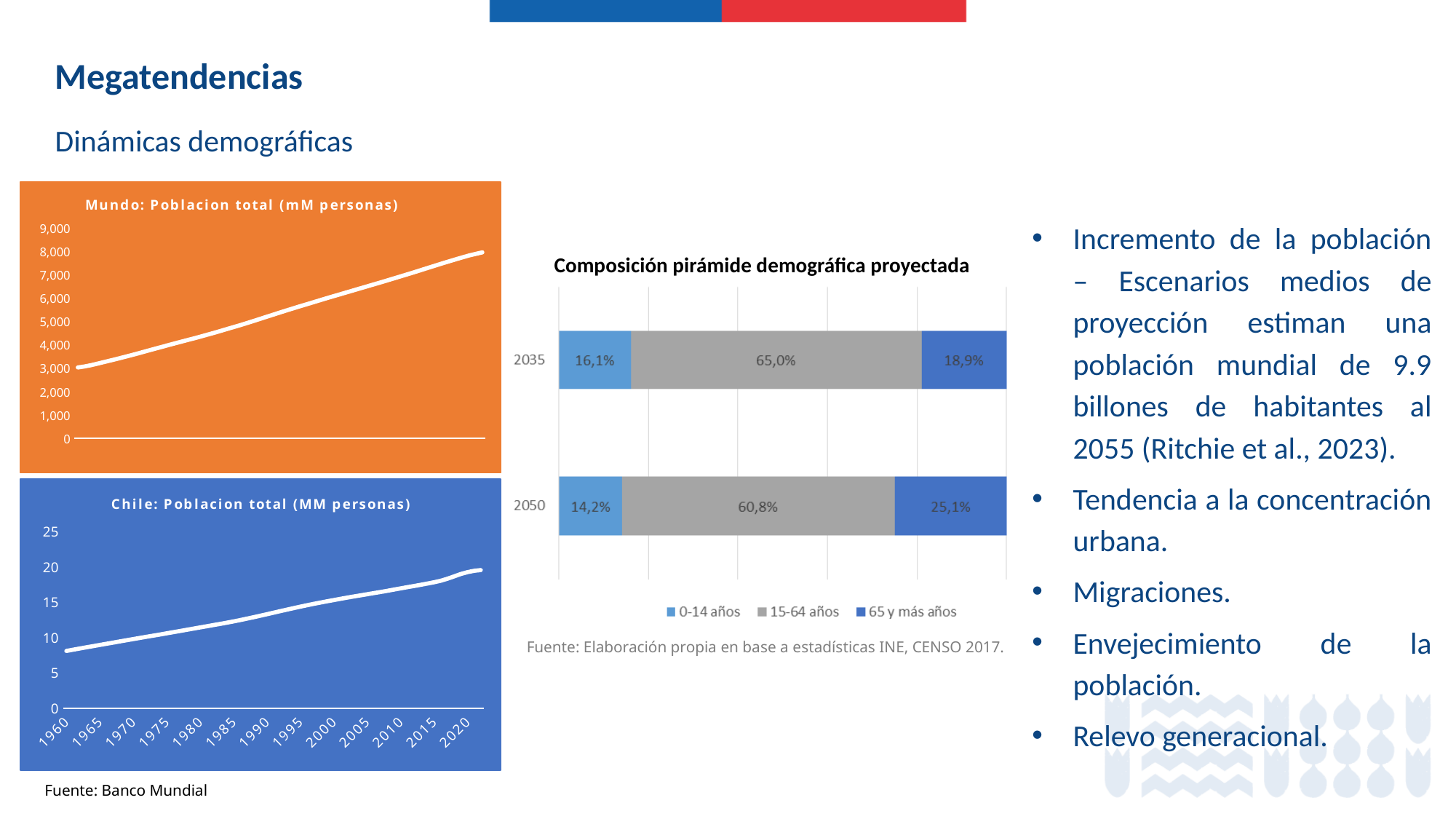
What kind of chart is 'Mundo: Poblacion total (mM personas)'? Line chart What kind of chart is 'Composición pirámide demográfica proyectada'? Stacked bar chart In the 'Composición pirámide demográfica proyectada' chart, what is the share of the 65 y más años group in 2050? 25,1% In the 'Mundo: Poblacion total (mM personas)' chart, does the line rise or fall from left to right? Rises In the 'Composición pirámide demográfica proyectada' chart, what is the share of the 15-64 años group in 2035? 65,0% How many years (bars) are shown in the 'Composición pirámide demográfica proyectada' chart? 2 In the 'Chile: Poblacion total (MM personas)' chart, is the value for 2020 greater or less than 15? greater In the 'Composición pirámide demográfica proyectada' chart, which year has the larger 0-14 años share, 2035 or 2050? 2035 In the 'Chile: Poblacion total (MM personas)' chart, is the value for 1960 greater or less than 10? less In the 'Composición pirámide demográfica proyectada' chart, by how many percentage points does the 65 y más años share in 2050 exceed that in 2035? 6,2 How many series does the legend of the 'Composición pirámide demográfica proyectada' chart list? 3 In the 'Composición pirámide demográfica proyectada' chart, what is the share of the 0-14 años group in 2050? 14,2%